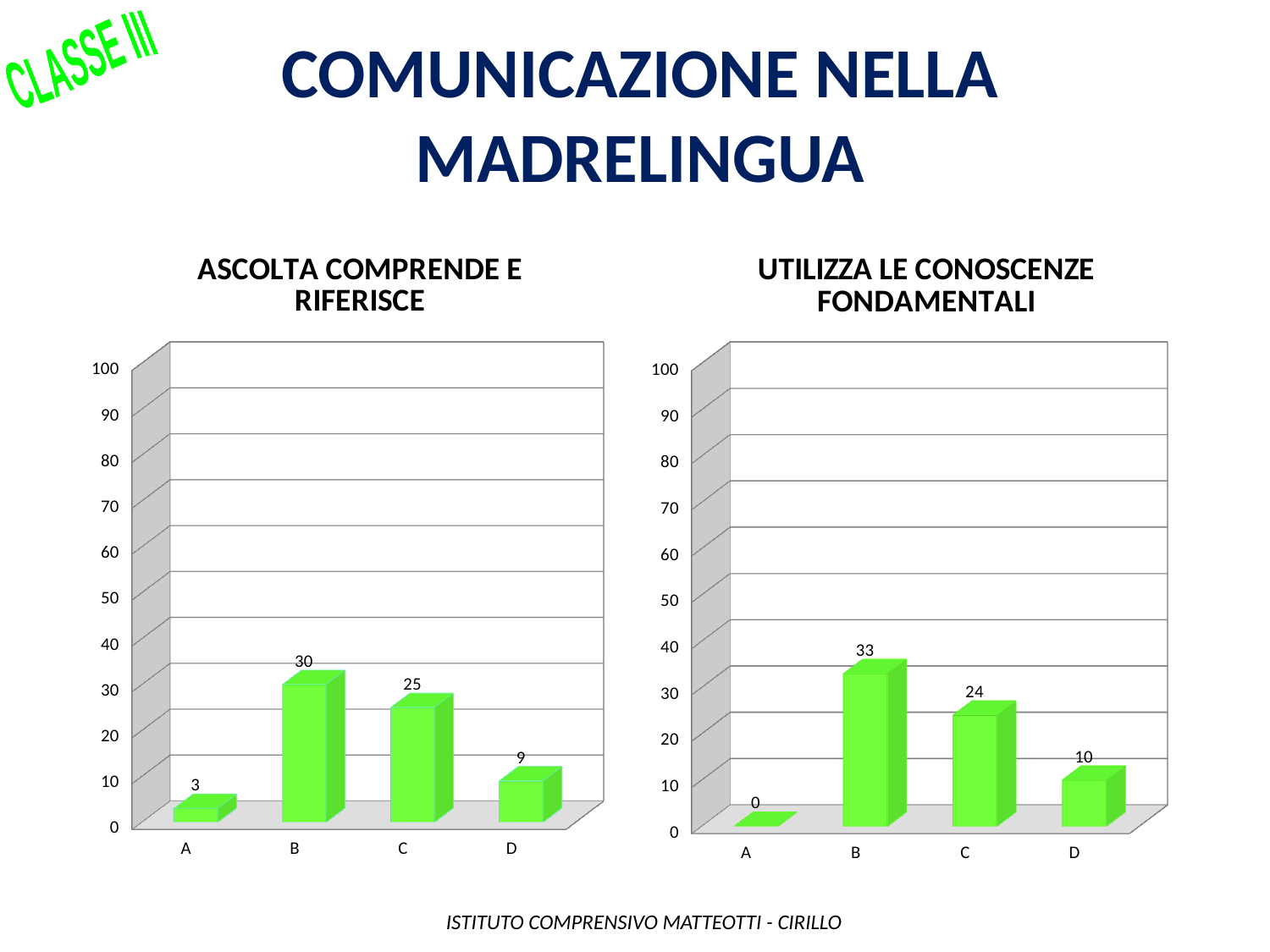
In the 'ASCOLTA COMPRENDE E RIFERISCE' chart, which category has the highest value? B In the 'UTILIZZA LE CONOSCENZE FONDAMENTALI' chart, what is the value for C? 24 What colour are the bars in the 'UTILIZZA LE CONOSCENZE FONDAMENTALI' chart? Green In the 'ASCOLTA COMPRENDE E RIFERISCE' chart, which is larger, the value for A or the value for D? D What kind of chart is the 'ASCOLTA COMPRENDE E RIFERISCE' chart? Bar chart In the 'UTILIZZA LE CONOSCENZE FONDAMENTALI' chart, which category has the lowest value? A How many categories are shown in the 'UTILIZZA LE CONOSCENZE FONDAMENTALI' chart? 4 In the 'ASCOLTA COMPRENDE E RIFERISCE' chart, what is the value for D? 9 In the 'UTILIZZA LE CONOSCENZE FONDAMENTALI' chart, what is the difference between the values for B and D? 23 In the 'UTILIZZA LE CONOSCENZE FONDAMENTALI' chart, what is the value for A? 0 In the 'ASCOLTA COMPRENDE E RIFERISCE' chart, what is the value for B? 30 In the 'ASCOLTA COMPRENDE E RIFERISCE' chart, what is the difference between the values for B and C? 5